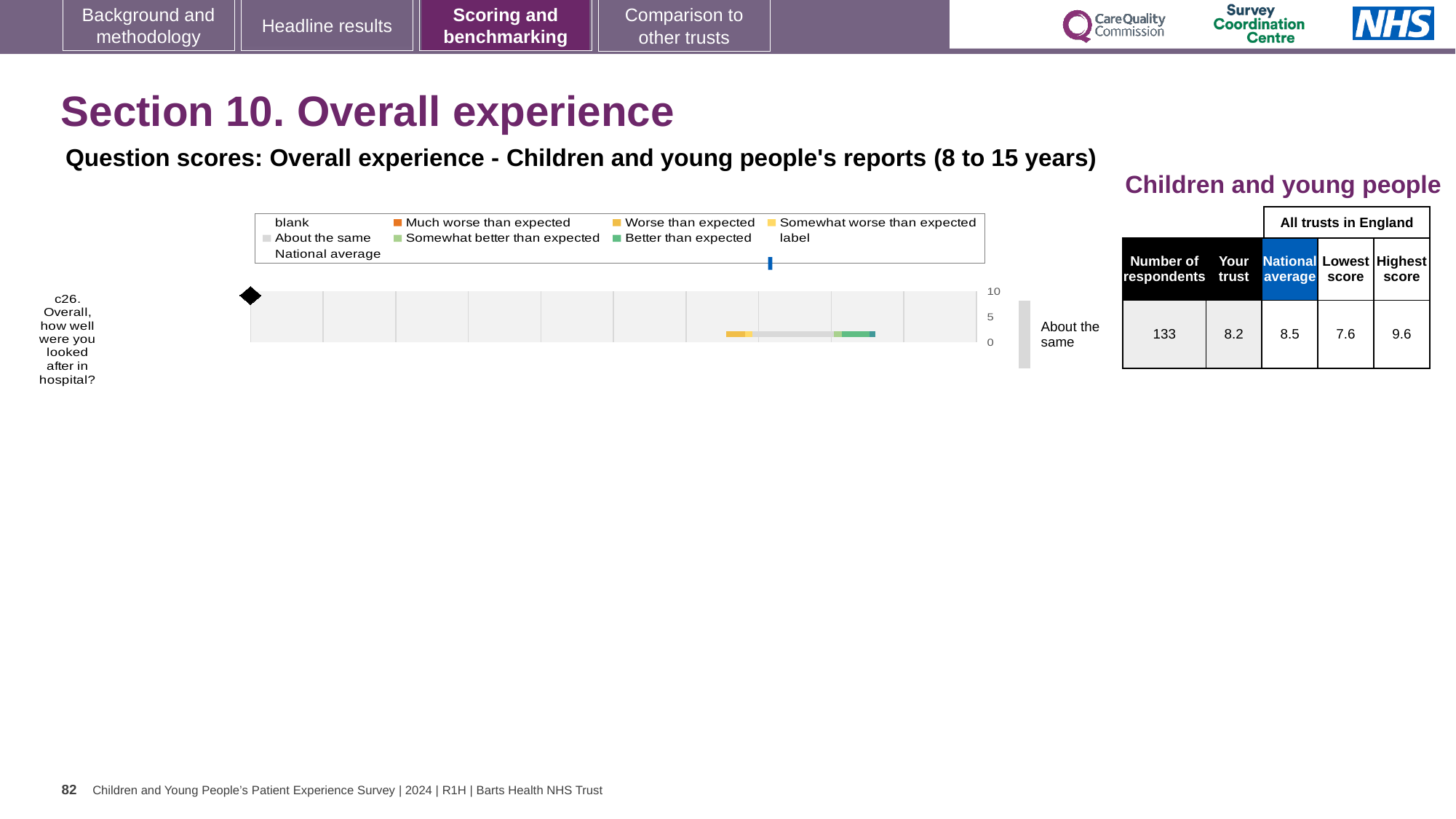
What kind of chart is used to show the question score on this slide? Bar chart Which legend entry is shown with an orange marker in the chart's legend? Much worse than expected How many respondents answered question c26 according to the table? 133 What is the difference between the highest score and the lowest score for question c26? 2.0 How is the trust's result for question c26 categorised, as shown to the right of the chart? About the same Which is larger for question c26: the trust's score or the national average? National average What is the national average score for question c26 shown in the table? 8.5 What is the difference between the national average and the trust's score for question c26? 0.3 What is the lowest score among all trusts in England for question c26? 7.6 What is the highest score among all trusts in England for question c26? 9.6 How many questions are plotted in the chart on this slide? 1 What is the trust's score for question c26 'Overall, how well were you looked after in hospital?' as shown in the table next to the chart? 8.2